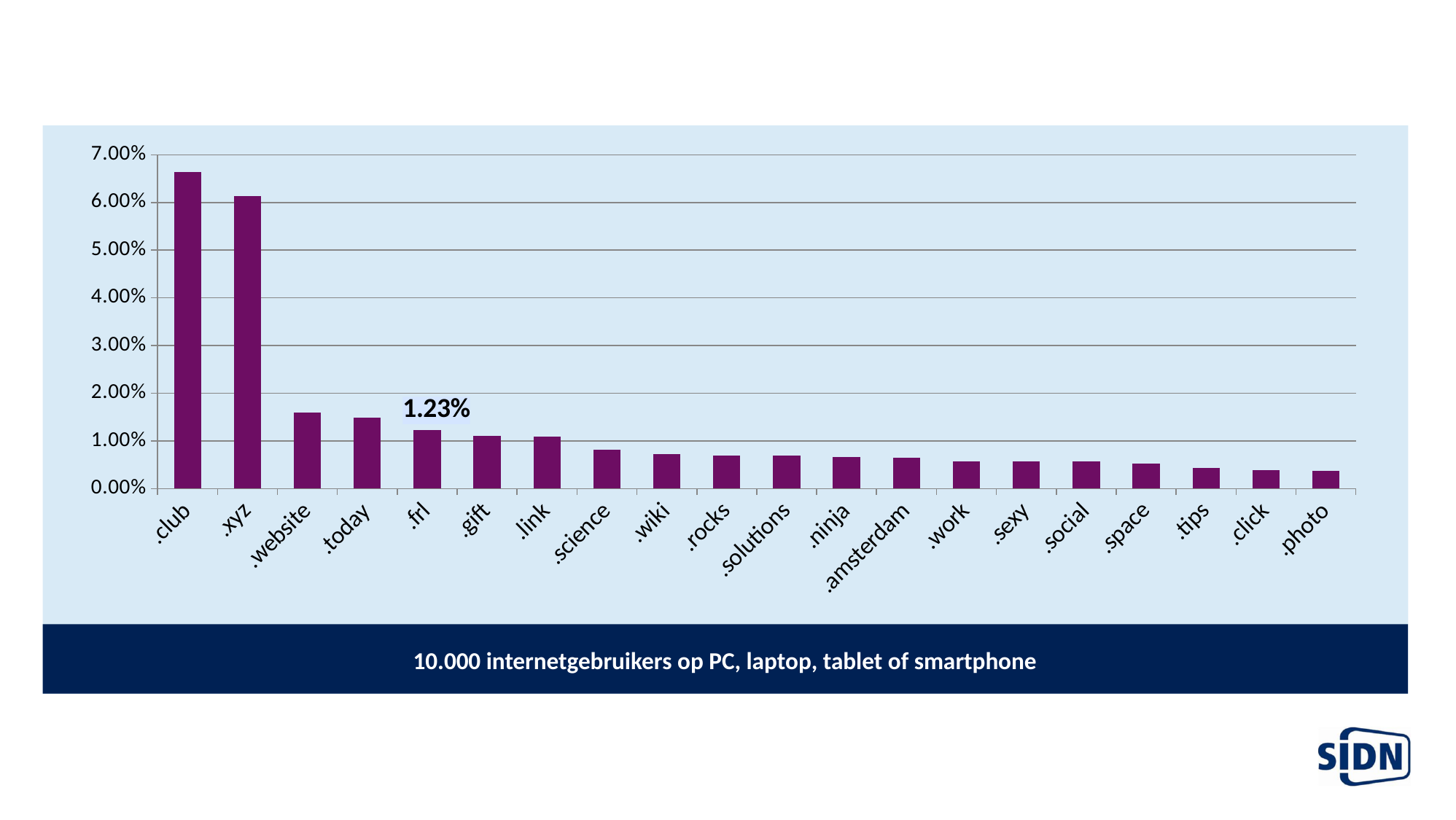
What kind of chart is shown on the slide? bar chart How many categories are shown on the x axis? 20 Is the value for .xyz greater or less than 5.00%? greater Is the value for .club greater or less than 6.00%? greater Which is larger, the value for .club or the value for .xyz? .club Which category has the highest value? .club Do the values rise or fall from left to right along the x axis? fall Is the value for .science greater or less than 1.00%? less What is the value for .frl? 1.23% What text appears in the dark band below the chart? 10.000 internetgebruikers op PC, laptop, tablet of smartphone Which is larger, the value for .website or the value for .gift? .website